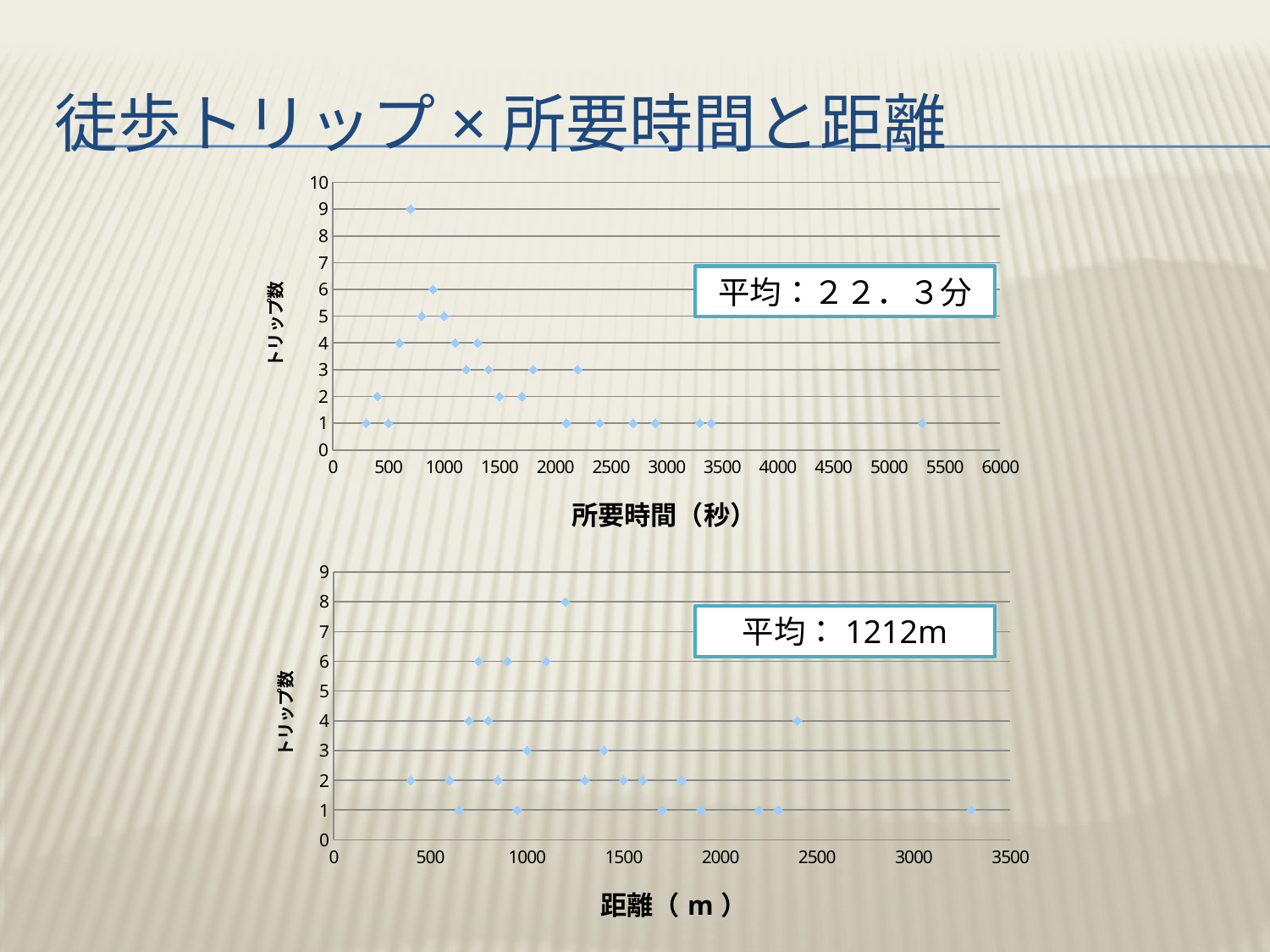
What kind of chart is the top chart on the slide? scatter chart In the top chart, is the duration of the rightmost point greater or less than 5000 seconds? greater What kind of chart is the bottom chart on the slide? scatter chart In the bottom chart, is the distance of the rightmost point greater or less than 3000 m? greater In the bottom chart, what is the maximum value shown on the x axis (距離)? 3500 In the top chart, is the duration (所要時間) of the point with the highest trip count greater or less than 1000 seconds? less In the top chart (所要時間), what is the highest trip count (トリップ数) reached by any point? 9 What average distance (平均) is shown in the text box on the bottom chart? 1212m In the top chart, what is the maximum value shown on the x axis (所要時間)? 6000 What average duration (平均) is shown in the text box on the top chart? ２２．３分 In the bottom chart (距離), what is the highest trip count (トリップ数) reached by any point? 8